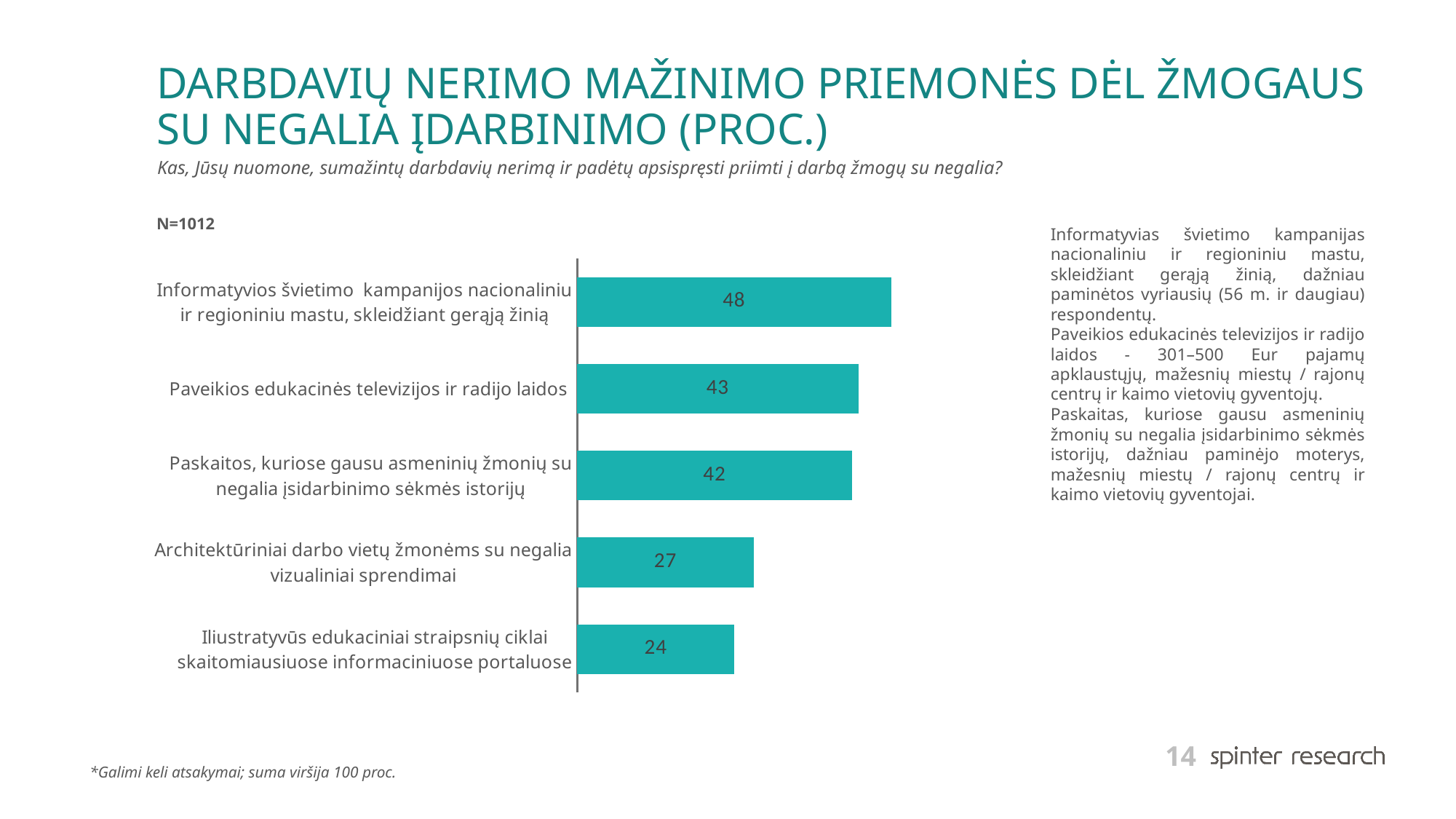
Which category has the highest value? Informatyvios švietimo kampanijos nacionaliniu ir regioniniu mastu, skleidžiant gerąją žinią Which is larger: the value for "Paveikios edukacinės televizijos ir radijo laidos" or the value for "Architektūriniai darbo vietų žmonėms su negalia vizualiniai sprendimai"? Paveikios edukacinės televizijos ir radijo laidos Which category has the lowest value? Iliustratyvūs edukaciniai straipsnių ciklai skaitomiausiuose informaciniuose portaluose What is the sample size (N) stated on the slide? N=1012 What is the value for "Paveikios edukacinės televizijos ir radijo laidos"? 43 What is the difference between the values for "Architektūriniai darbo vietų žmonėms su negalia vizualiniai sprendimai" and "Iliustratyvūs edukaciniai straipsnių ciklai skaitomiausiuose informaciniuose portaluose"? 3 What is the value for "Architektūriniai darbo vietų žmonėms su negalia vizualiniai sprendimai"? 27 How many categories are shown in the chart? 5 What is the difference between the values for "Informatyvios švietimo kampanijos nacionaliniu ir regioniniu mastu, skleidžiant gerąją žinią" and "Paskaitos, kuriose gausu asmeninių žmonių su negalia įsidarbinimo sėkmės istorijų"? 6 What kind of chart is shown on the slide? Bar chart What is the value for "Iliustratyvūs edukaciniai straipsnių ciklai skaitomiausiuose informaciniuose portaluose"? 24 What colour are the bars in the chart? Teal